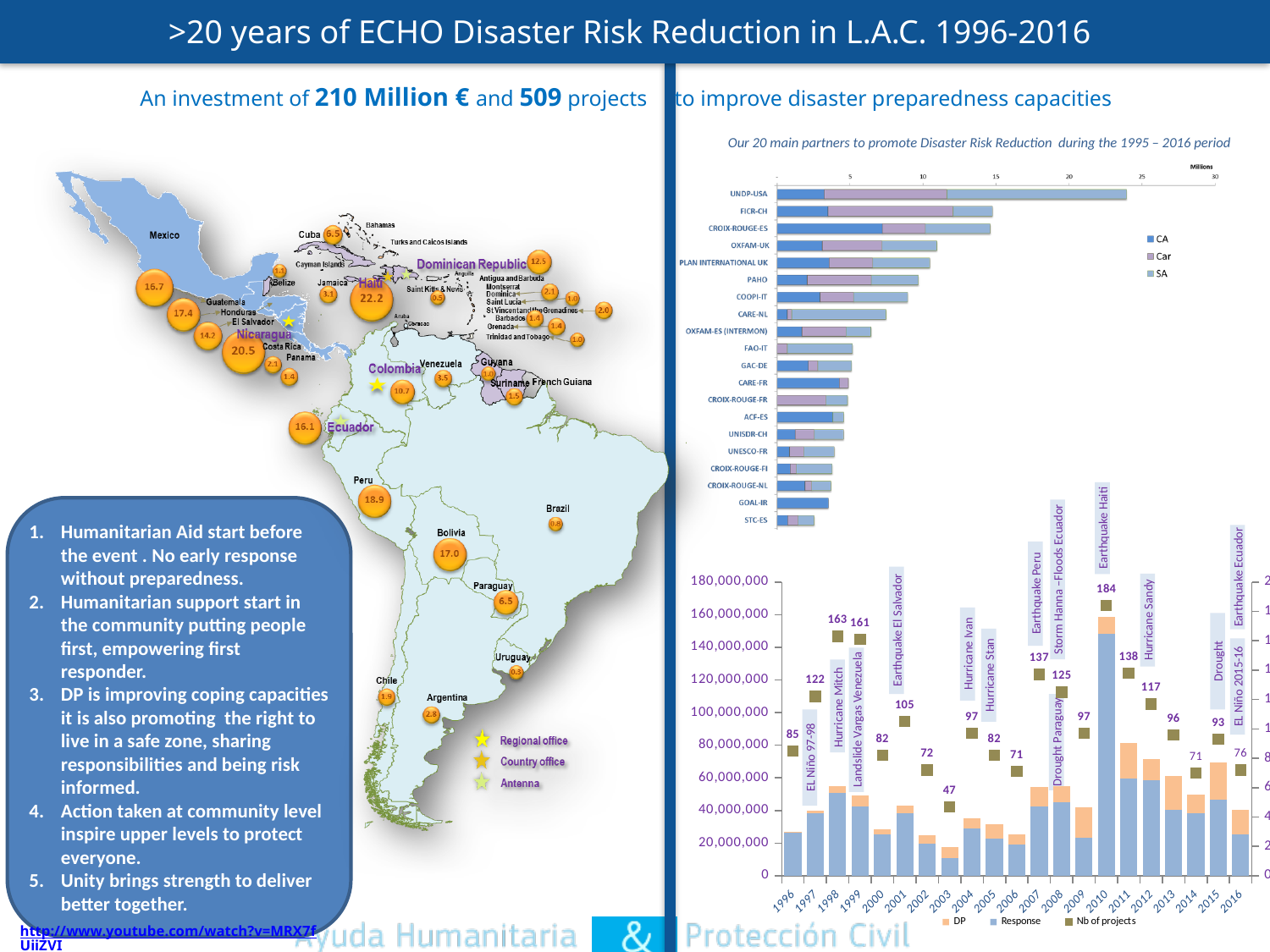
In the yearly chart at the bottom right, how many years are shown on the x axis? 21 In the chart of the 20 main partners (top right), which partner has the longest bar? UNDP-USA What kind of chart is the chart of the 20 main partners (top right)? bar chart In the yearly chart at the bottom right, what is the number of projects (Nb of projects) for 2010? 184 In the yearly chart at the bottom right, which year has the lowest number of projects? 2003 In the chart of the 20 main partners (top right), which partner has the shortest bar? STC-ES In the chart of the 20 main partners (top right), is the total value for UNDP-USA greater or less than 20 Millions? greater In the chart of the 20 main partners (top right), is the total value for OXFAM-UK greater or less than 15 Millions? less In the chart of the 20 main partners (top right), how many series does the legend list? 3 In the yearly chart at the bottom right, what is the difference between the number of projects in 2010 and in 2003? 137 In the chart of the 20 main partners (top right), what are the legend entries? CA, Car, SA In the yearly chart at the bottom right, which year has more projects, 2007 or 2008? 2007